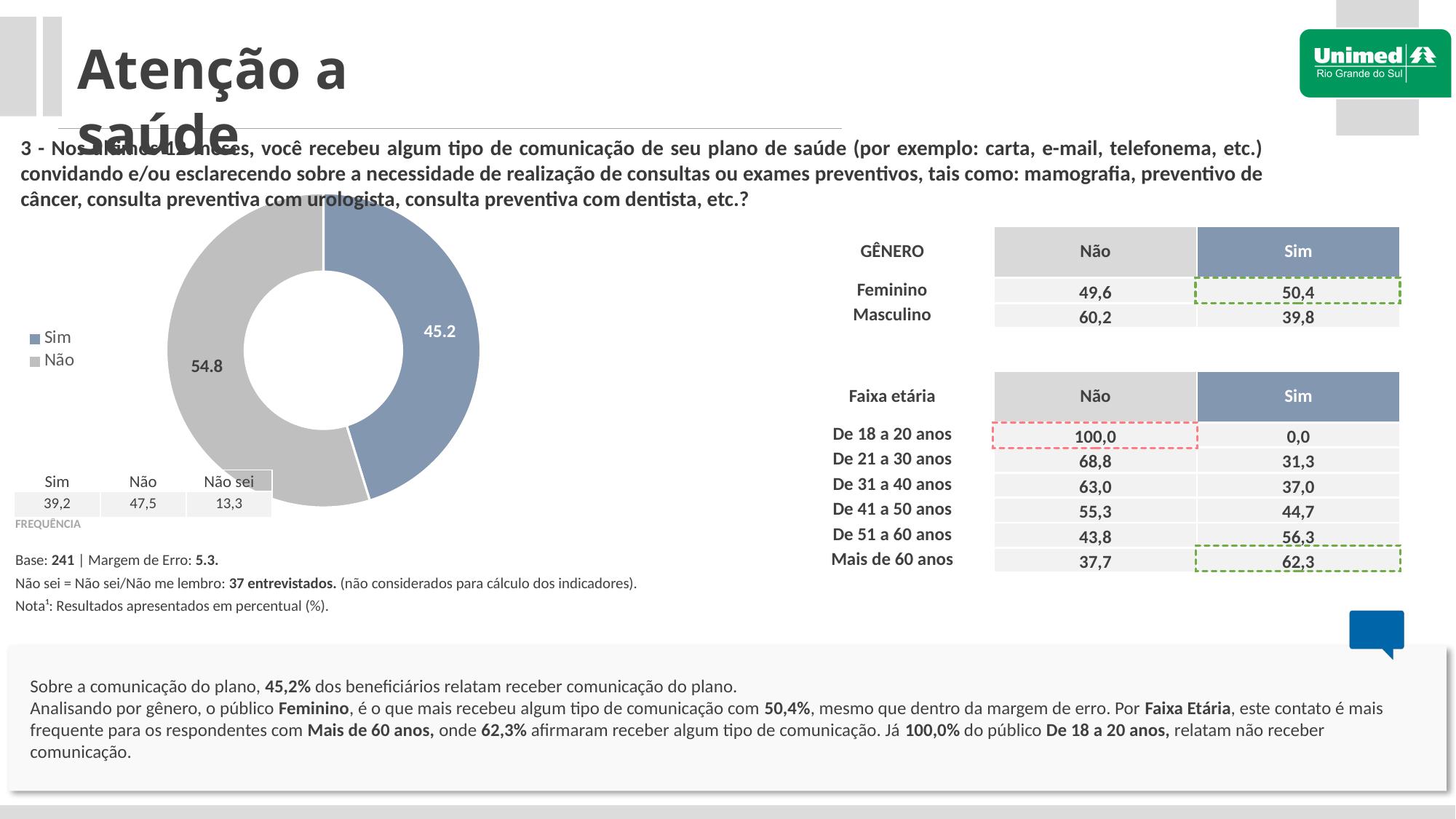
What share of the donut chart does the "Sim" slice represent? 45.2% Which slice of the donut chart is the largest? Não In the donut chart, which is larger: "Sim" or "Não"? Não What colour is the "Sim" slice in the donut chart? Blue Which slice of the donut chart is the smallest? Sim What are the two legend entries of the donut chart? Sim and Não What is the value shown for the "Não" slice of the donut chart? 54.8 What kind of chart is shown on the slide? Donut (pie) chart How many slices does the donut chart have? 2 What is the value shown for the "Sim" slice of the donut chart? 45.2 How many entries does the legend of the donut chart list? 2 What is the difference between the "Não" and "Sim" values in the donut chart? 9.6